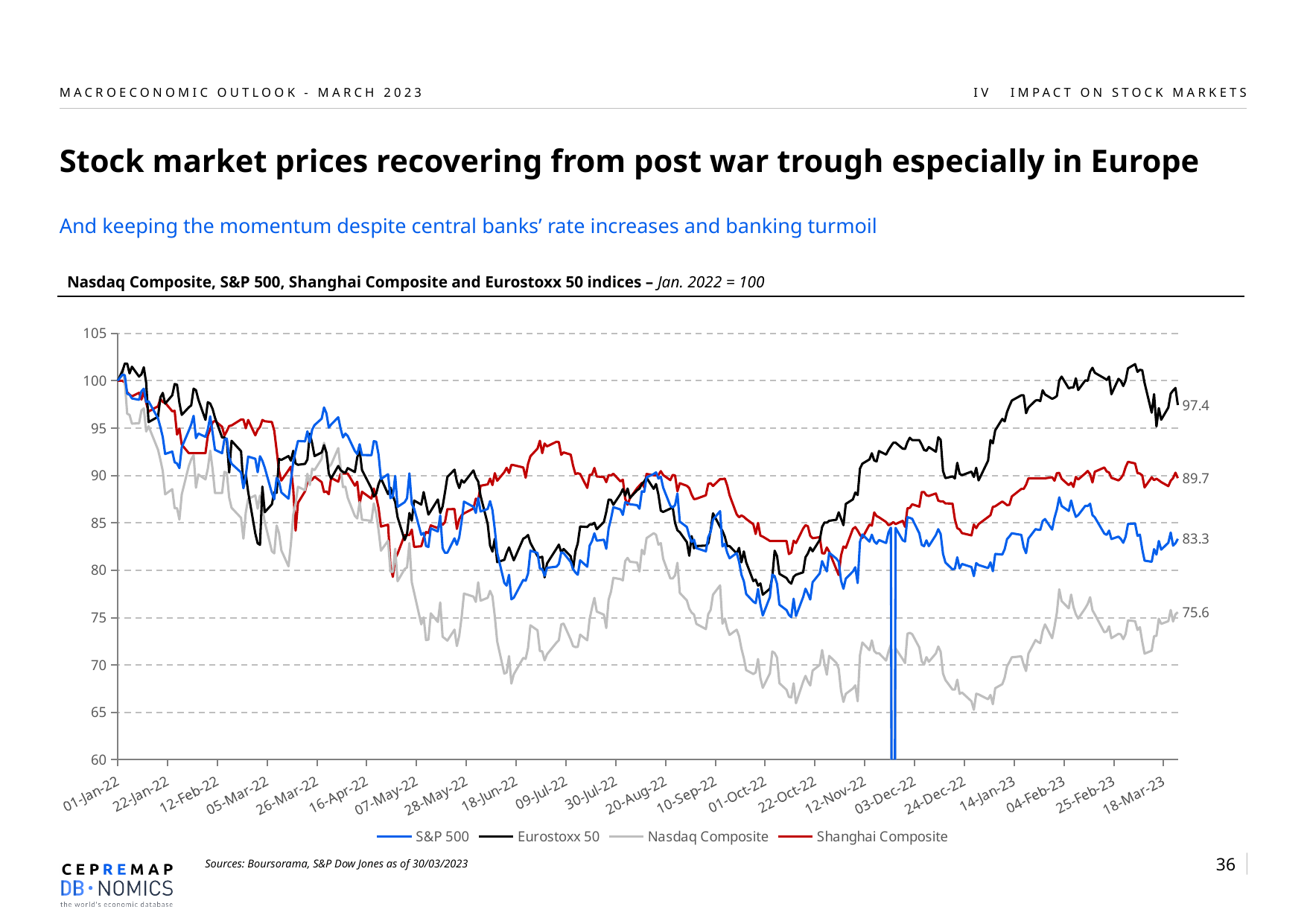
How many series does the legend list? 4 What base value are the indices rebased to, according to the chart title? Jan. 2022 = 100 What is the difference between the final labelled values of the Eurostoxx 50 (97.4) and the Nasdaq Composite (75.6)? 21.8 What is the final labelled value of the S&P 500 series at the right end of the chart? 83.3 Which index has the lowest labelled value at the right end of the chart? Nasdaq Composite Which index has the highest labelled value at the right end of the chart? Eurostoxx 50 What is the final labelled value of the Nasdaq Composite series at the right end of the chart? 75.6 At the right end of the chart, which is larger: the Shanghai Composite value or the S&P 500 value? Shanghai Composite Is the Nasdaq Composite value around 18-Jun-22 greater or less than 75? less What type of chart is shown on the slide? Line chart What is the final labelled value of the Shanghai Composite series at the right end of the chart? 89.7 What is the final labelled value of the Eurostoxx 50 series at the right end of the chart? 97.4